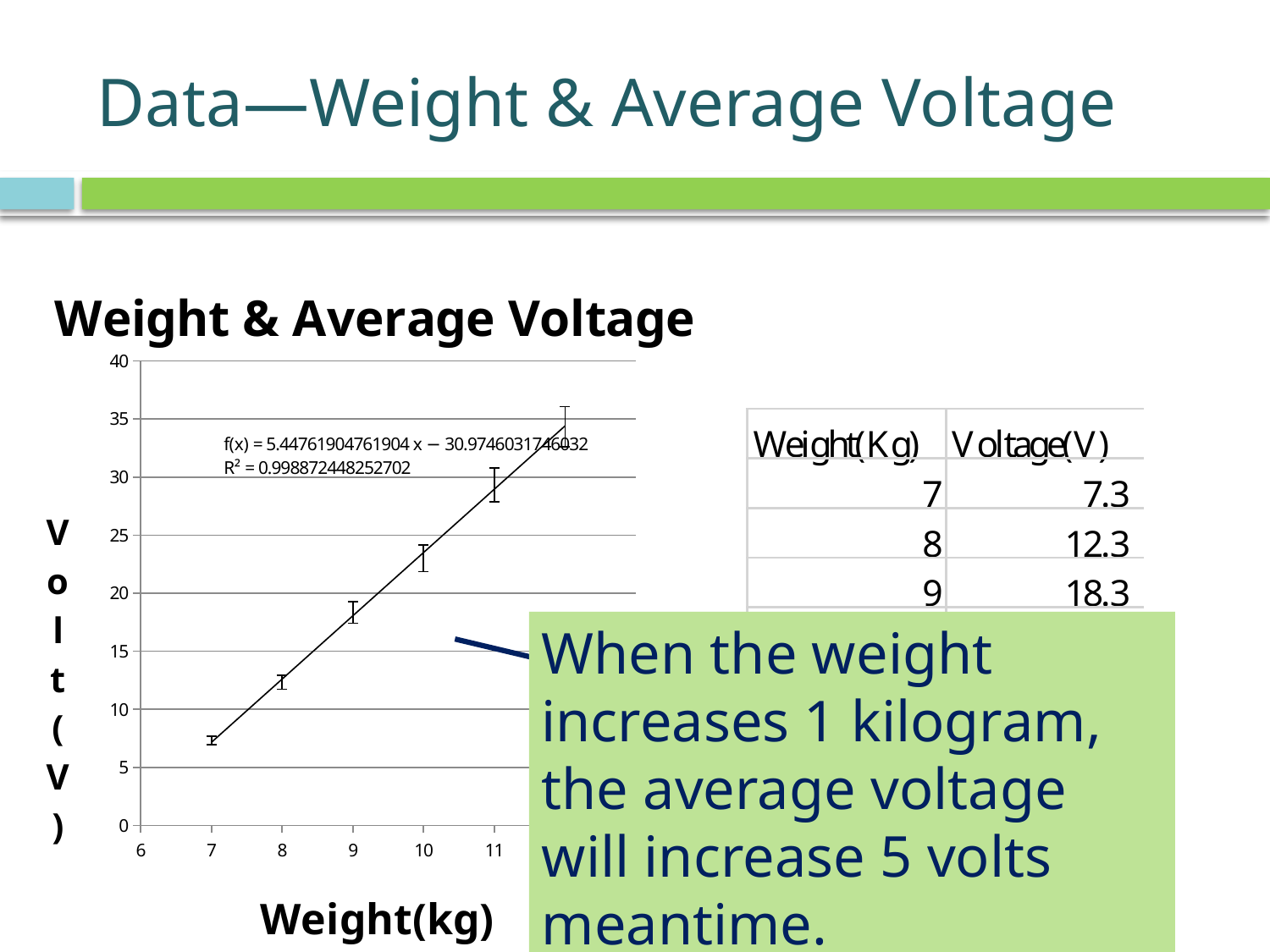
Which weight has the lowest voltage? 7 kg What is the difference in voltage between 8 kg and 7 kg? 5 What is the voltage for a weight of 9 kg? 18.3 Which has the higher voltage, 9 kg or 8 kg? 9 kg Is the voltage for 10 kg greater or less than 20? greater Is the voltage for 11 kg greater or less than 25? greater What is the title of the chart? Weight & Average Voltage What is the voltage for a weight of 7 kg? 7.3 What kind of chart is shown on the slide? scatter chart How many data points are plotted on the chart? 6 What is the voltage for a weight of 8 kg? 12.3 Do the voltage values rise or fall as weight increases along the x axis? rise